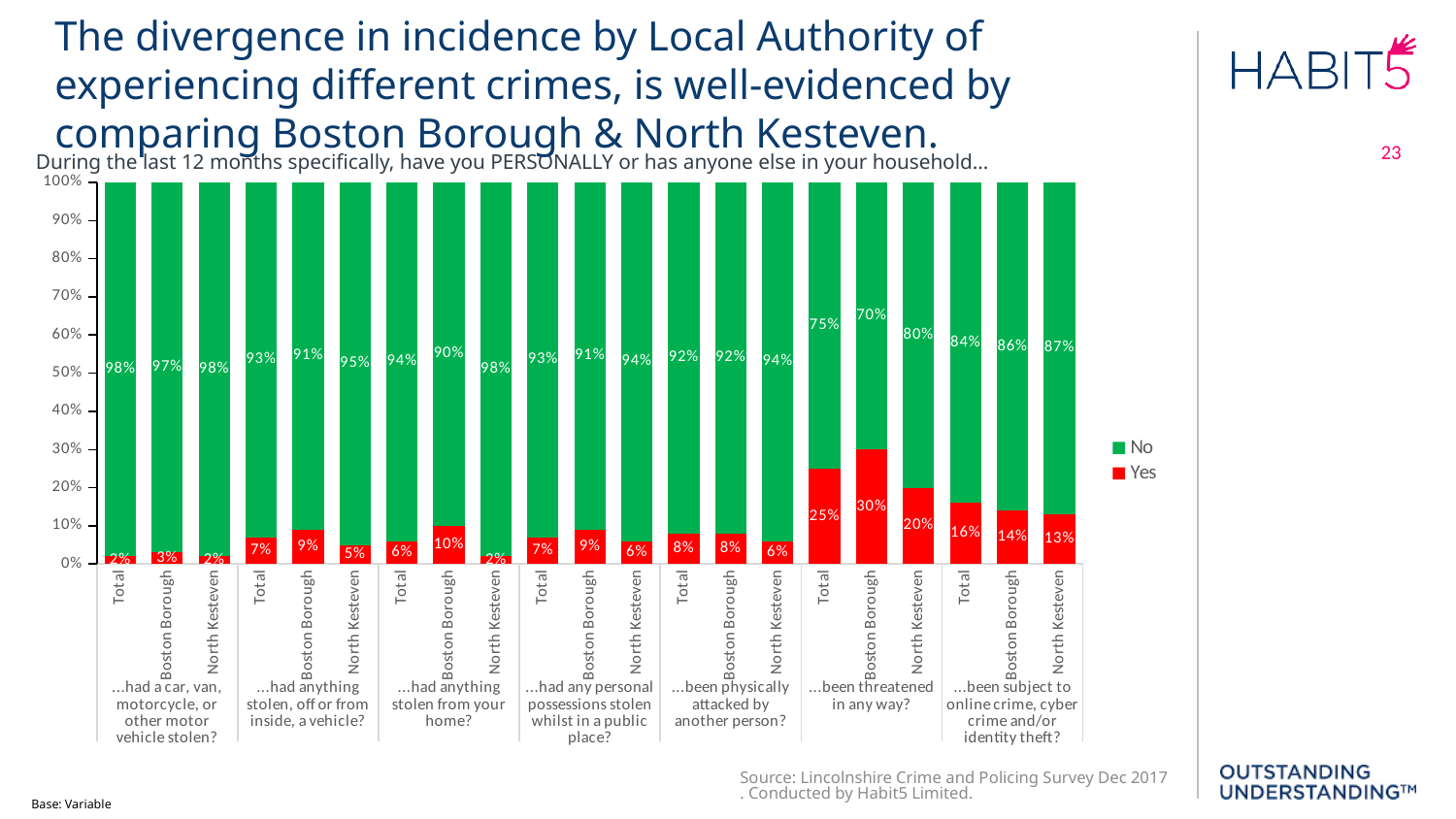
What is the difference between the Yes values for Boston Borough and North Kesteven for having had anything stolen from your home? 8% What is the total of the stacked bar for Total for having been physically attacked by another person? 100% How many bars are plotted on the chart? 21 Which colour represents the Yes series in the chart? Red What kind of chart is shown on the slide? Stacked bar chart Which bar has the highest Yes value on the chart? Boston Borough, been threatened in any way What percentage of Boston Borough respondents answered Yes to having been threatened in any way? 30% What is the No value for North Kesteven for having had anything stolen from your home? 98% Which area has the lowest Yes value for having been threatened in any way? North Kesteven How many series does the legend list? 2 What is the Yes value for Total for having been subject to online crime, cyber crime and/or identity theft? 16% Which is larger: the Yes value for Boston Borough or for North Kesteven for having been subject to online crime? Boston Borough